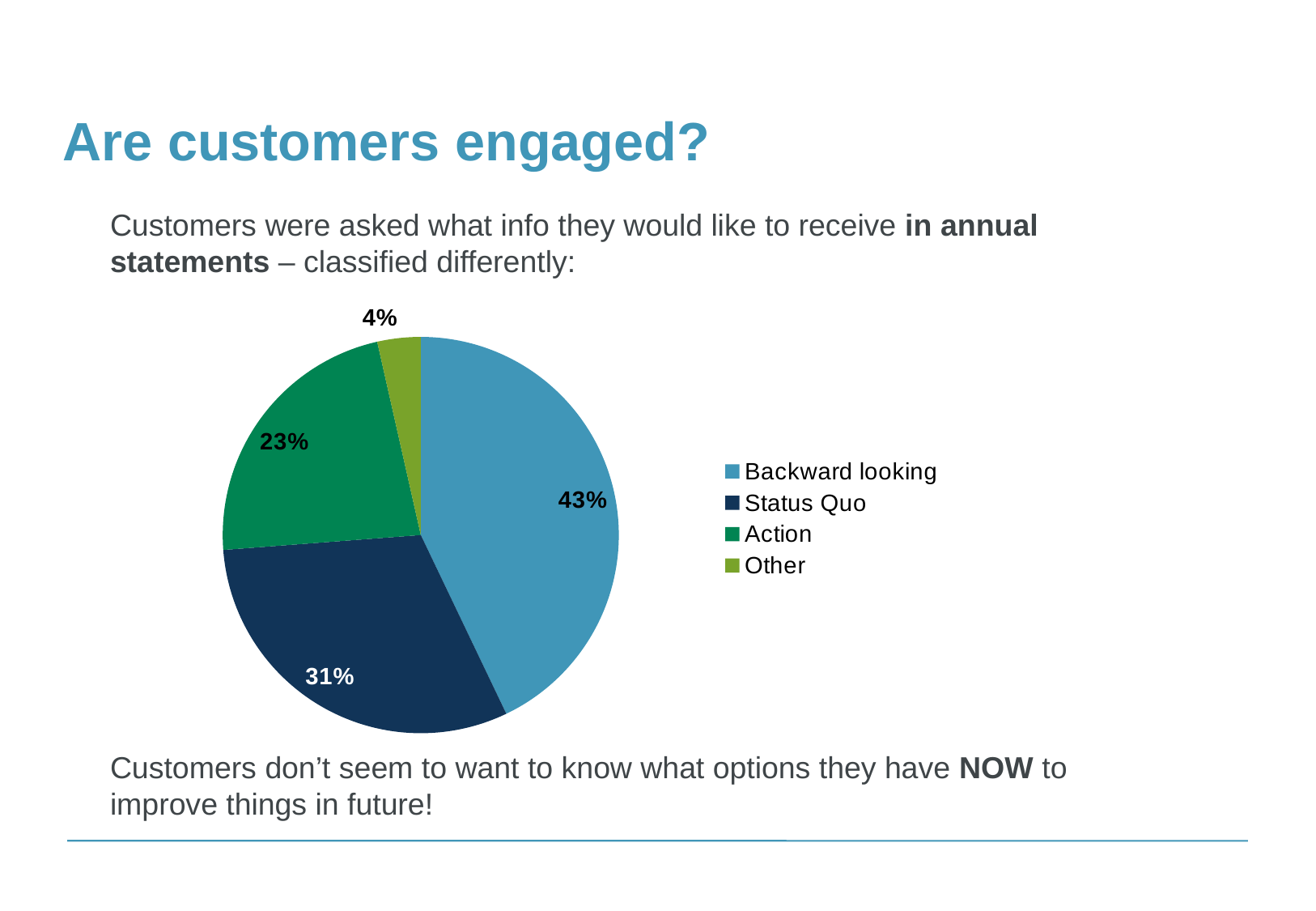
Which category has the largest slice of the pie? Backward looking What colour is the Other slice in the legend? Light green What kind of chart is shown on the slide? Pie chart What is the difference in percentage points between Backward looking and Status Quo? 12 Which category has the smallest slice of the pie? Other What is the difference in percentage points between Action and Other? 19 What share of the pie is Status Quo? 31% How many categories does the pie chart show? 4 What share of the pie is Backward looking? 43% What share of the pie is Action? 23% What share of the pie is Other? 4% Which is larger, Status Quo or Action? Status Quo